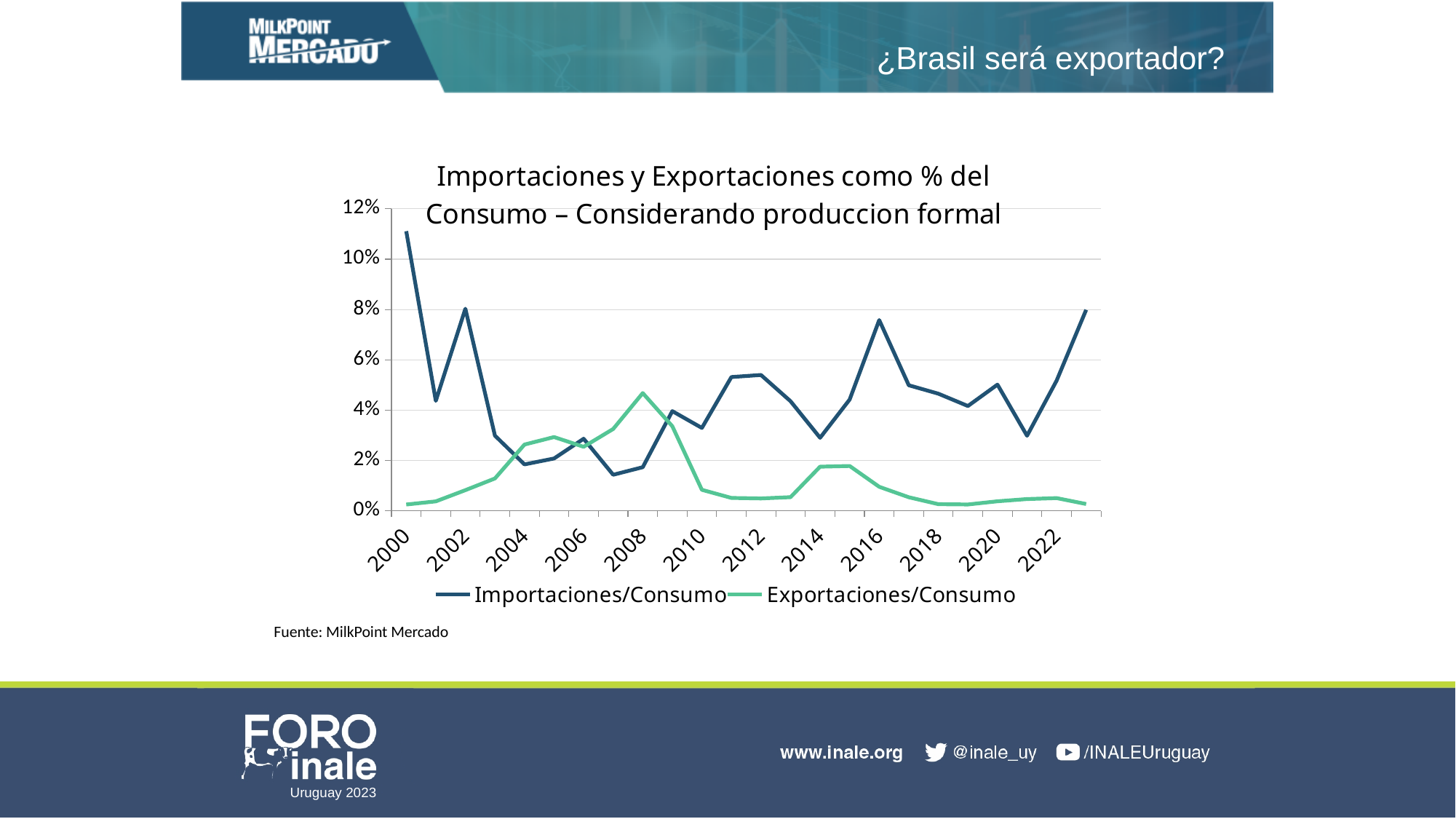
How many series does the legend list? 2 What kind of chart is shown on the slide? line chart How many year labels are shown on the x axis? 12 Does the Exportaciones/Consumo series rise or fall from 2008 to 2010? fall In which year does the Exportaciones/Consumo series reach its highest value? 2008 Is the value for Exportaciones/Consumo in 2022 greater or less than 2%? less In 2008, which series has the higher value, Importaciones/Consumo or Exportaciones/Consumo? Exportaciones/Consumo What are the two series named in the legend? Importaciones/Consumo and Exportaciones/Consumo Is the value for Exportaciones/Consumo in 2008 greater or less than 4%? greater In which year does the Importaciones/Consumo series reach its highest value? 2000 Is the value for Importaciones/Consumo in 2000 greater or less than 10%? greater